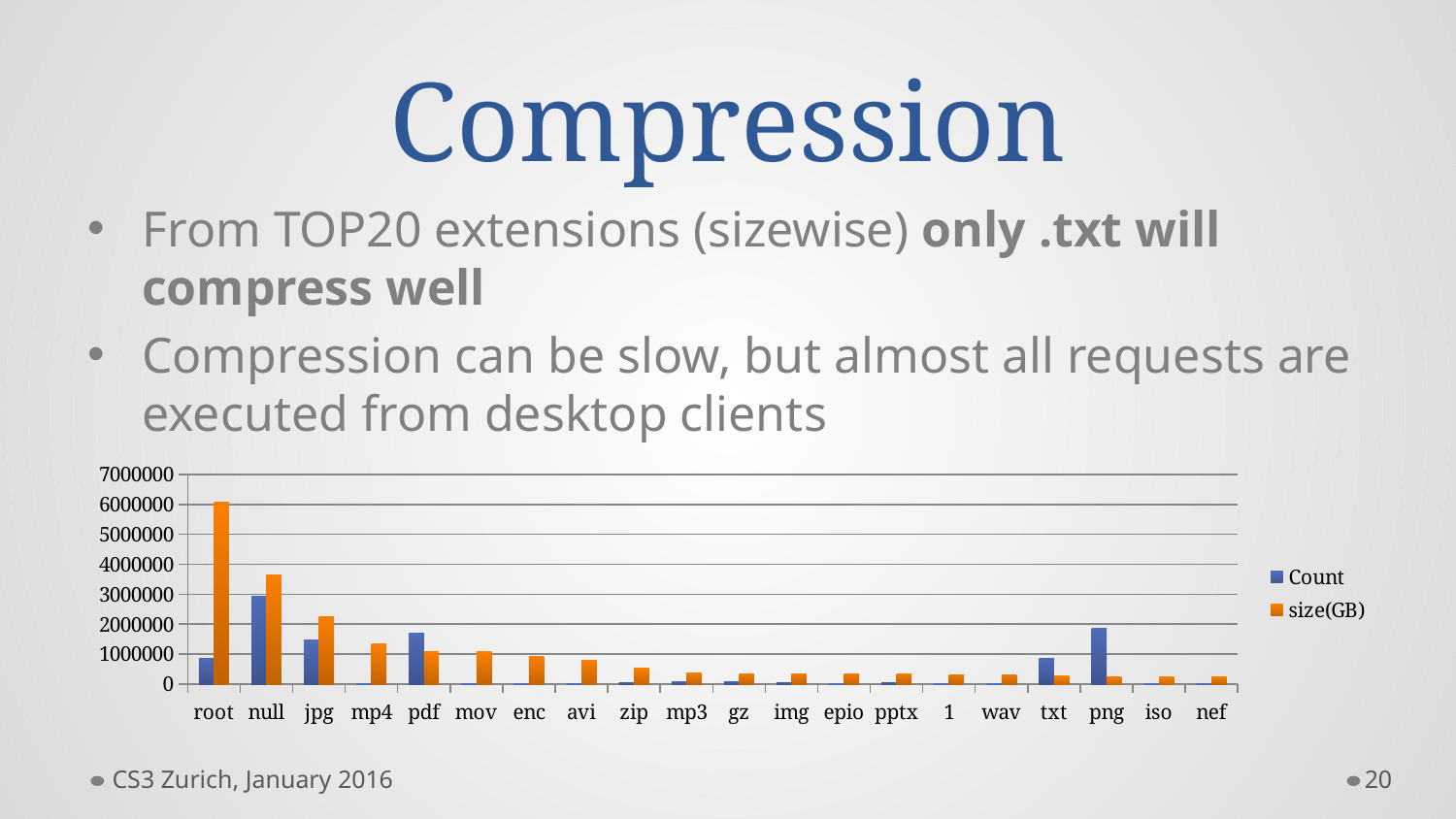
Is the Count value for null greater or less than 2000000? greater What are the two series named in the legend? Count and size(GB) How many file extension categories are shown on the x axis? 20 Is the Count value for txt greater or less than 1000000? less What kind of chart is shown on the slide? bar chart Which category has the highest Count value? null Is the size(GB) value for root greater or less than 5000000? greater Which is larger, the size(GB) value for root or the size(GB) value for null? root How many series does the legend list? 2 Which category has the highest size(GB) value? root Do the size(GB) values generally rise or fall moving from left to right along the x axis? fall